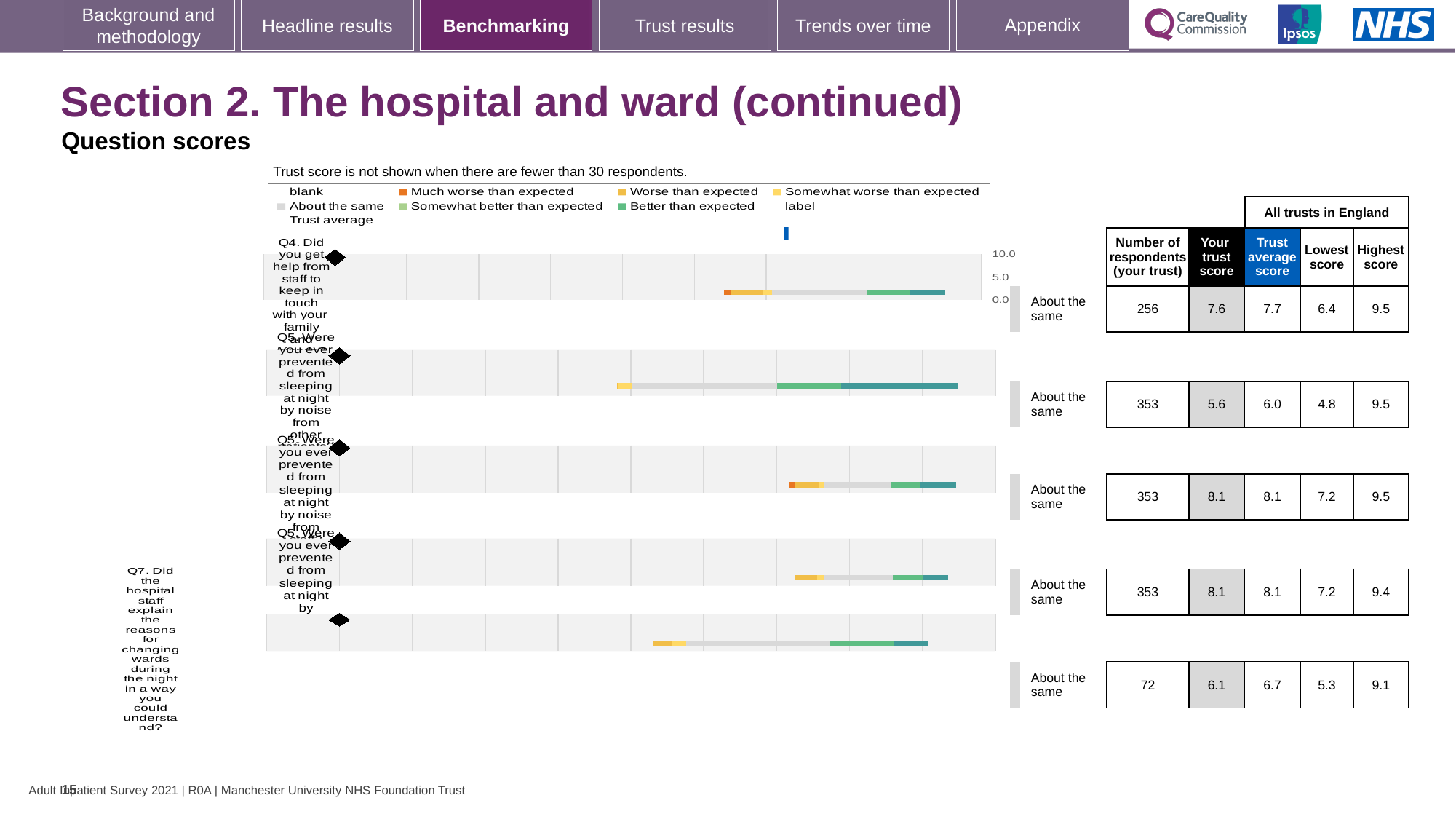
What is the difference between the highest score (9.5) and the lowest score (6.4) for Q4? 3.1 What benchmark category is shown for every question row on this slide? About the same In the table next to the chart, how many respondents are shown for Q4 (help from staff to keep in touch with family and friends)? 256 What is the highest score across all trusts in England for Q7 (explaining reasons for changing wards during the night)? 9.1 What is the lowest score across all trusts in England for Q7? 5.3 What is the trust average score for Q4 in the table beside the chart? 7.7 Which question row has the fewest respondents in the table beside the chart? Q7 What kind of chart is used to show the question scores on this slide? bar chart What is the 'Your trust score' for Q4 in the table beside the chart? 7.6 Which is larger for Q7: the trust's own score or the trust average score? the trust average score (6.7) How many question rows (bars) are shown in the benchmarking chart? 5